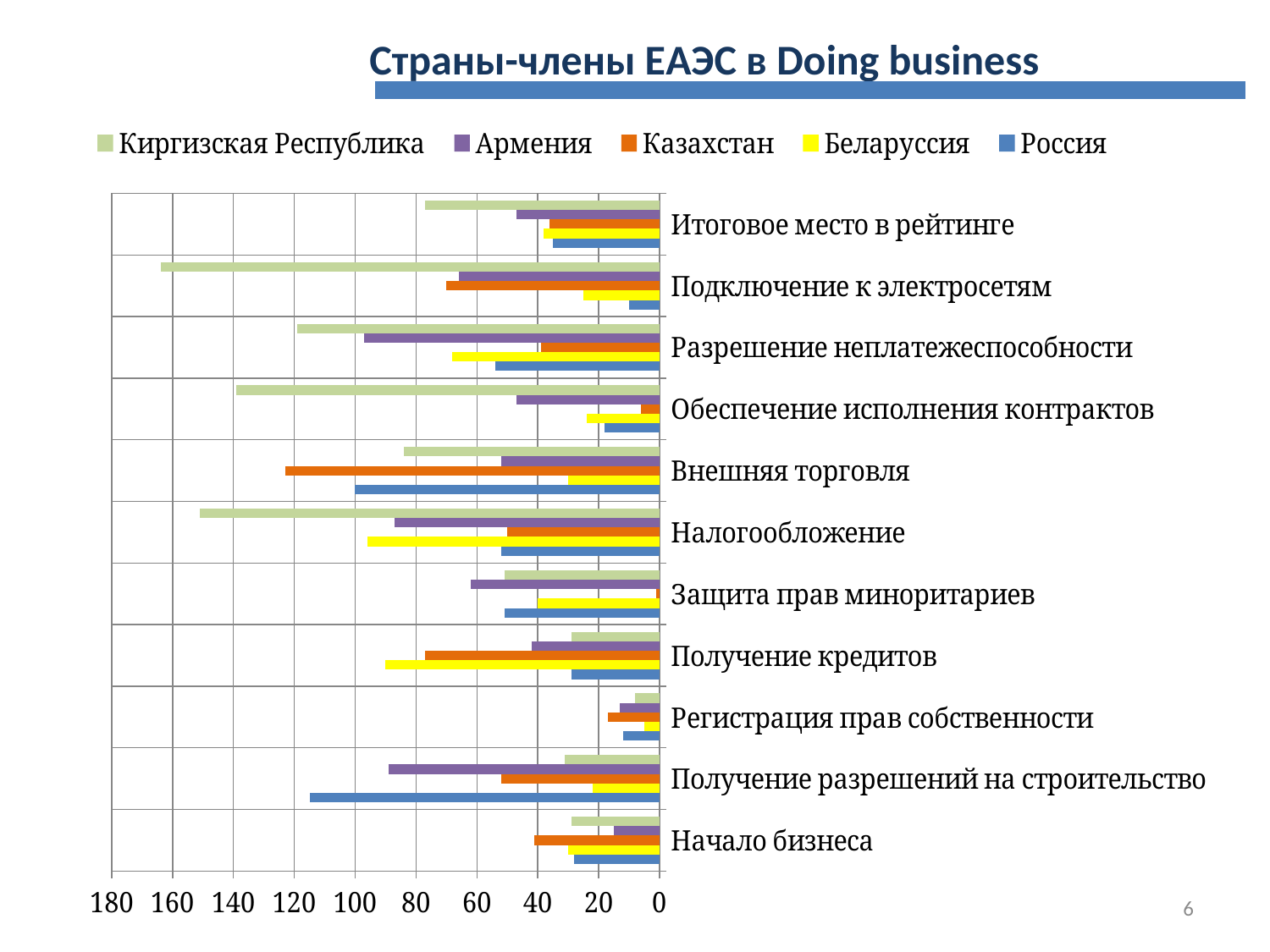
How many series does the legend list? 5 Is the value for Россия in Получение разрешений на строительство greater or less than 100? greater How many categories are plotted on the chart? 11 What is the title of the chart on the slide? Страны-члены ЕАЭС в Doing business Is the value for Киргизская Республика in Подключение к электросетям greater or less than 140? greater Which country has the lowest value in Получение разрешений на строительство? Беларуссия In Внешняя торговля, which is larger: the value for Казахстан or the value for Беларуссия? Казахстан Which country has the highest value in Подключение к электросетям? Киргизская Республика Is the value for Казахстан in Обеспечение исполнения контрактов greater or less than 20? less Which series is shown in yellow in the legend? Беларуссия What kind of chart is shown on the slide? bar chart In Получение кредитов, which is larger: the value for Беларуссия or the value for Армения? Беларуссия